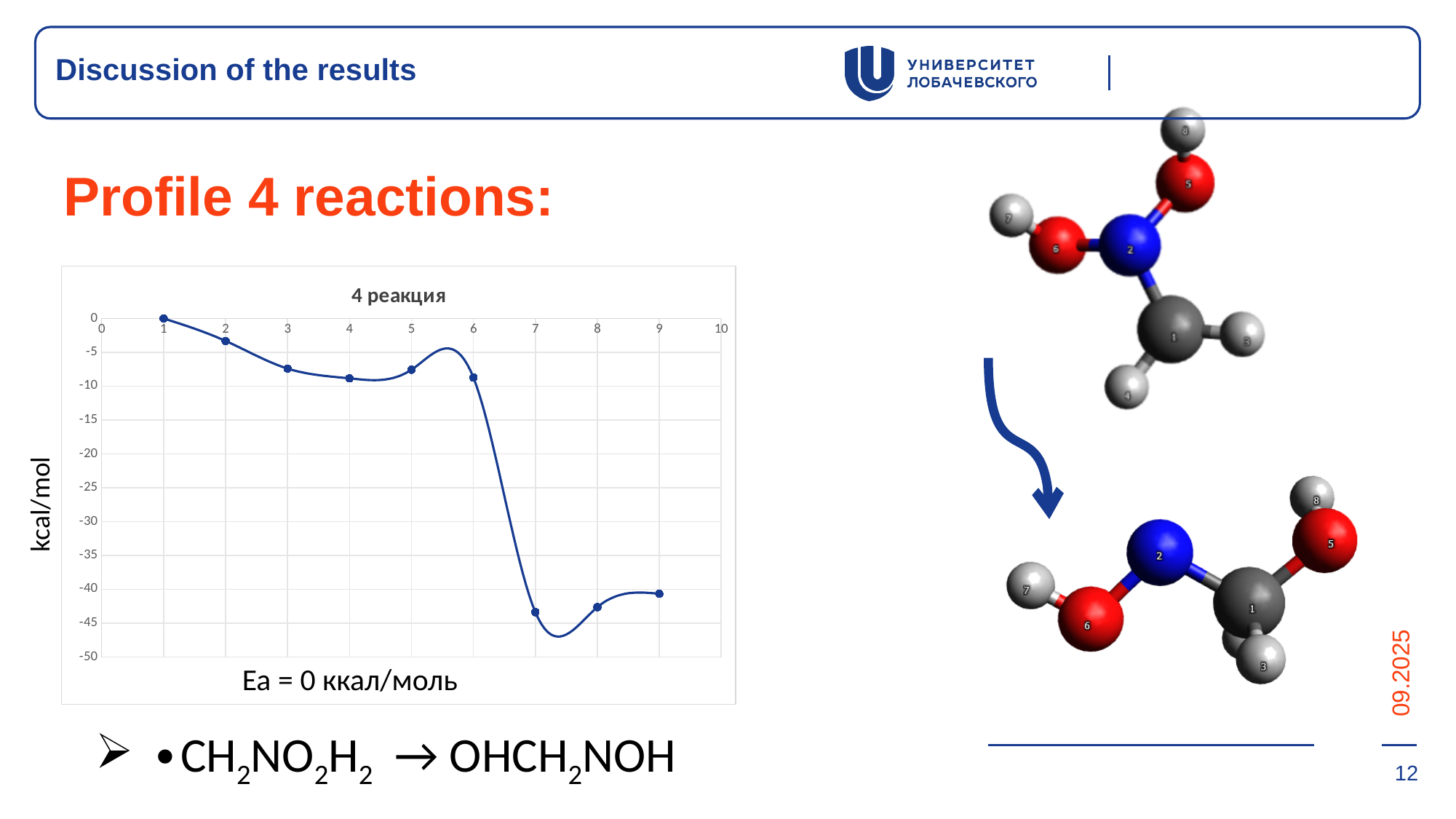
How many data points are plotted on the chart? 9 Is the value at x = 2 greater or less than -5? greater What is the value at x = 1 on the chart? 0 What kind of chart is shown on the slide? line chart Do the values rise or fall overall from x = 1 to x = 7? fall Which is larger, the value at x = 2 or the value at x = 7? x = 2 At which x value is the plotted value lowest? 7 Is the value at x = 7 greater or less than -40? less Is the value at x = 8 greater or less than -40? less What is the label on the vertical axis of the chart? kcal/mol What is the title of the chart? 4 реакция At which x value is the plotted value highest? 1